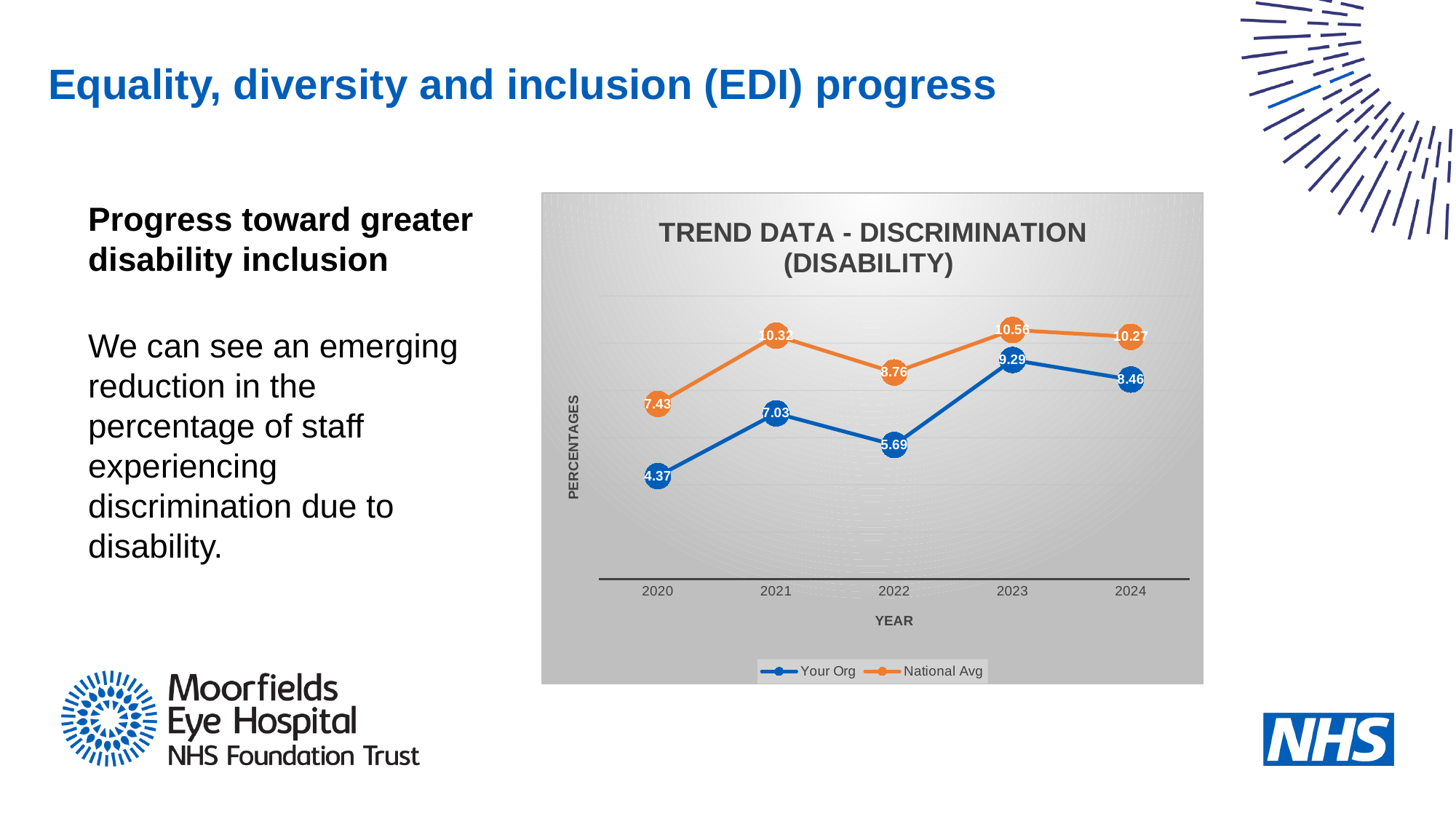
What is the title of the chart? TREND DATA - DISCRIMINATION (DISABILITY) What is the value for Your Org in 2024? 8.46 In which year is the Your Org value highest? 2023 What kind of chart is shown? Line chart How many years are shown on the x axis? 5 What is the difference between National Avg and Your Org in 2021? 3.29 What is the value for National Avg in 2022? 8.76 Did the Your Org value rise or fall from 2023 to 2024? Fall What is the value for Your Org in 2020? 4.37 How many series does the legend list? 2 Which is larger in 2023, Your Org or National Avg? National Avg In which year is the National Avg value lowest? 2020